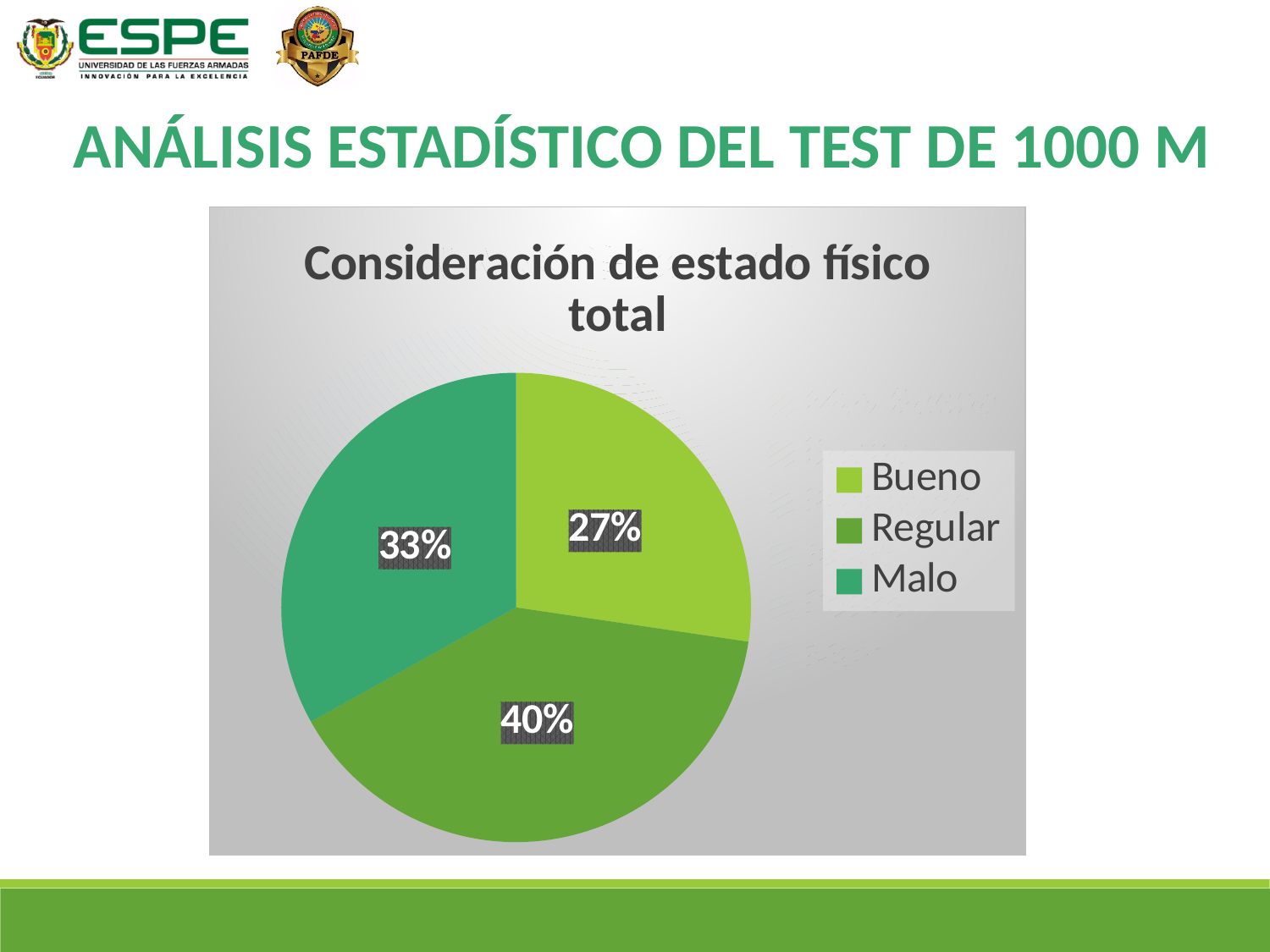
How many slices does the pie chart have? 3 Which category has the largest share of the pie? Regular What share of the pie does Bueno represent? 27% What share of the pie does Regular represent? 40% What share of the pie does Malo represent? 33% What kind of chart is shown on the slide? Pie chart Which legend entry is listed first? Bueno Which is larger, the share for Malo or the share for Bueno? Malo Which category has the smallest share of the pie? Bueno What is the difference in percentage points between Malo and Bueno? 6 What is the title of the chart? Consideración de estado físico total What is the difference in percentage points between Regular and Bueno? 13